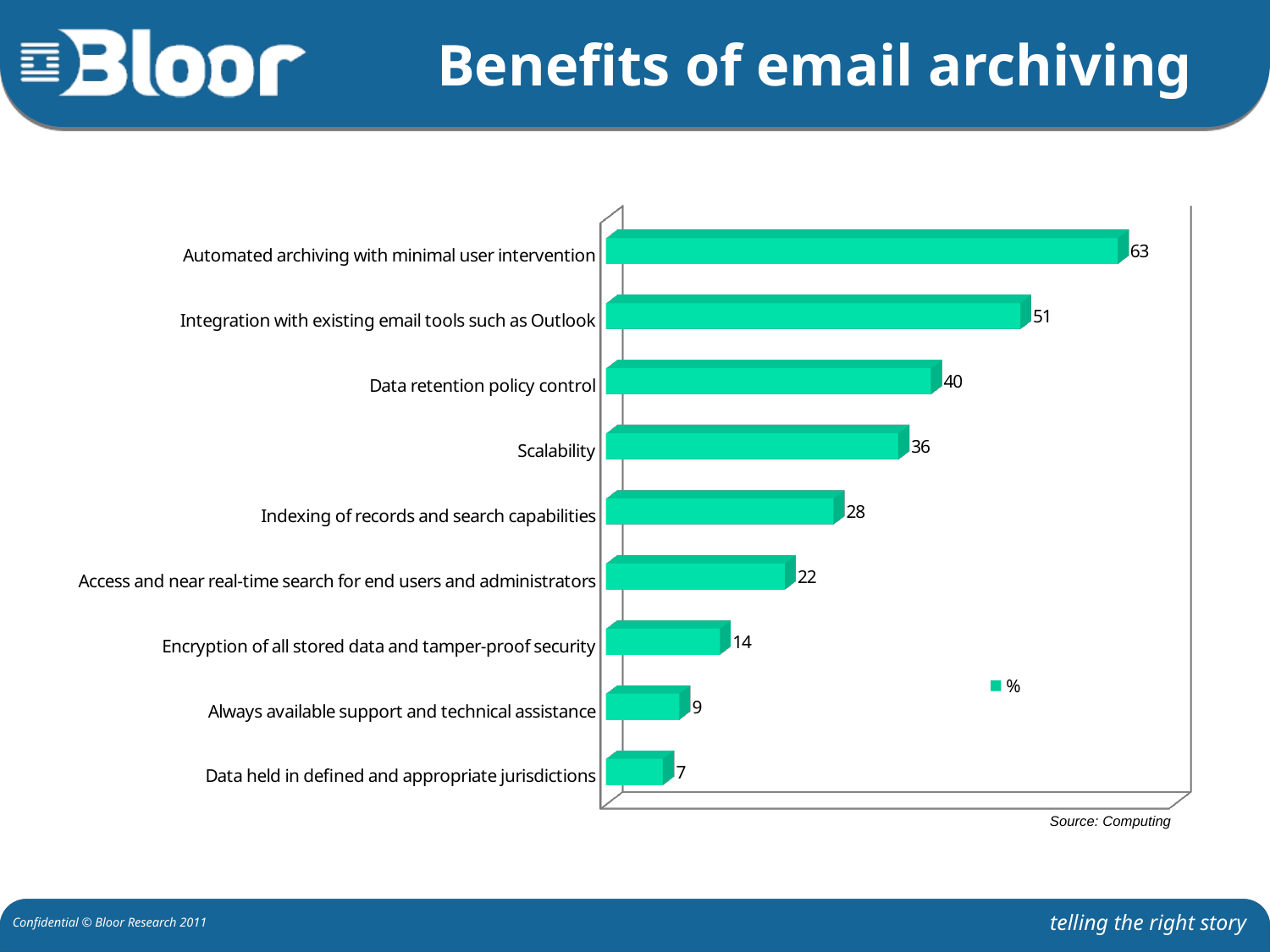
What is the title of the slide? Benefits of email archiving What is the difference between the values for Integration with existing email tools such as Outlook and Scalability? 15 Which category has the lowest value? Data held in defined and appropriate jurisdictions What is the value for Encryption of all stored data and tamper-proof security? 14 What is the source cited for the chart? Computing Which category has the highest value? Automated archiving with minimal user intervention How many series does the legend list? 1 Which is larger: the value for Indexing of records and search capabilities or the value for Access and near real-time search for end users and administrators? Indexing of records and search capabilities What kind of chart is shown on the slide? Bar chart What is the value for Data retention policy control? 40 What is the value for Automated archiving with minimal user intervention? 63 How many categories are shown in the chart? 9